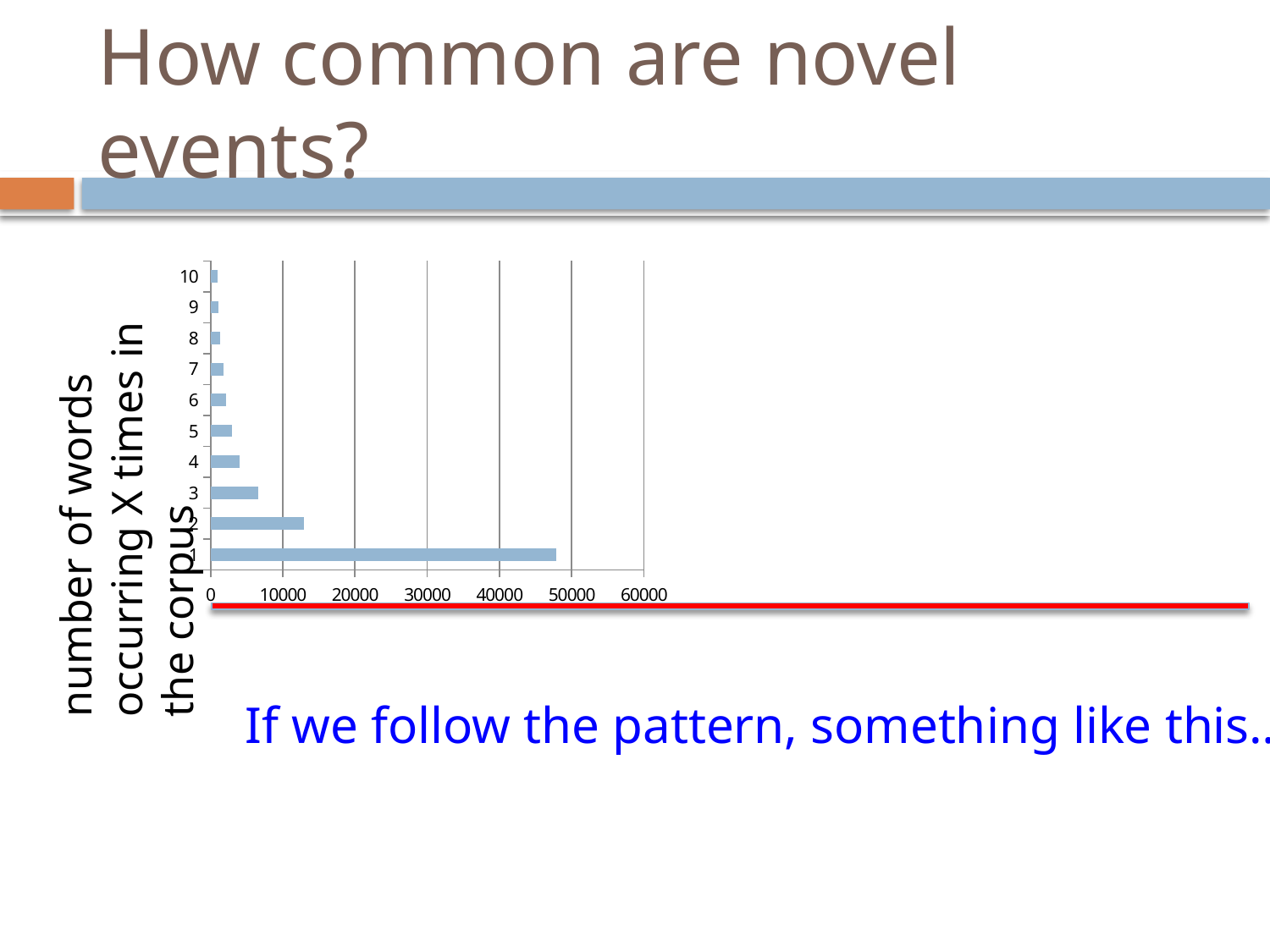
Which is larger, the value for category 3 or the value for category 4? 3 Is the value for category 2 greater or less than 20000? less Do the bar values rise or fall as the category number increases from 1 to 10? fall Is the value for category 1 greater or less than 40000? greater What is the highest tick value shown on the horizontal axis? 60000 Which category has the longest bar? 1 Is the value for category 1 greater or less than 50000? less What kind of chart is shown on the slide? bar chart Which is larger, the value for category 1 or the value for category 2? 1 How many categories (bars) are plotted on the chart? 10